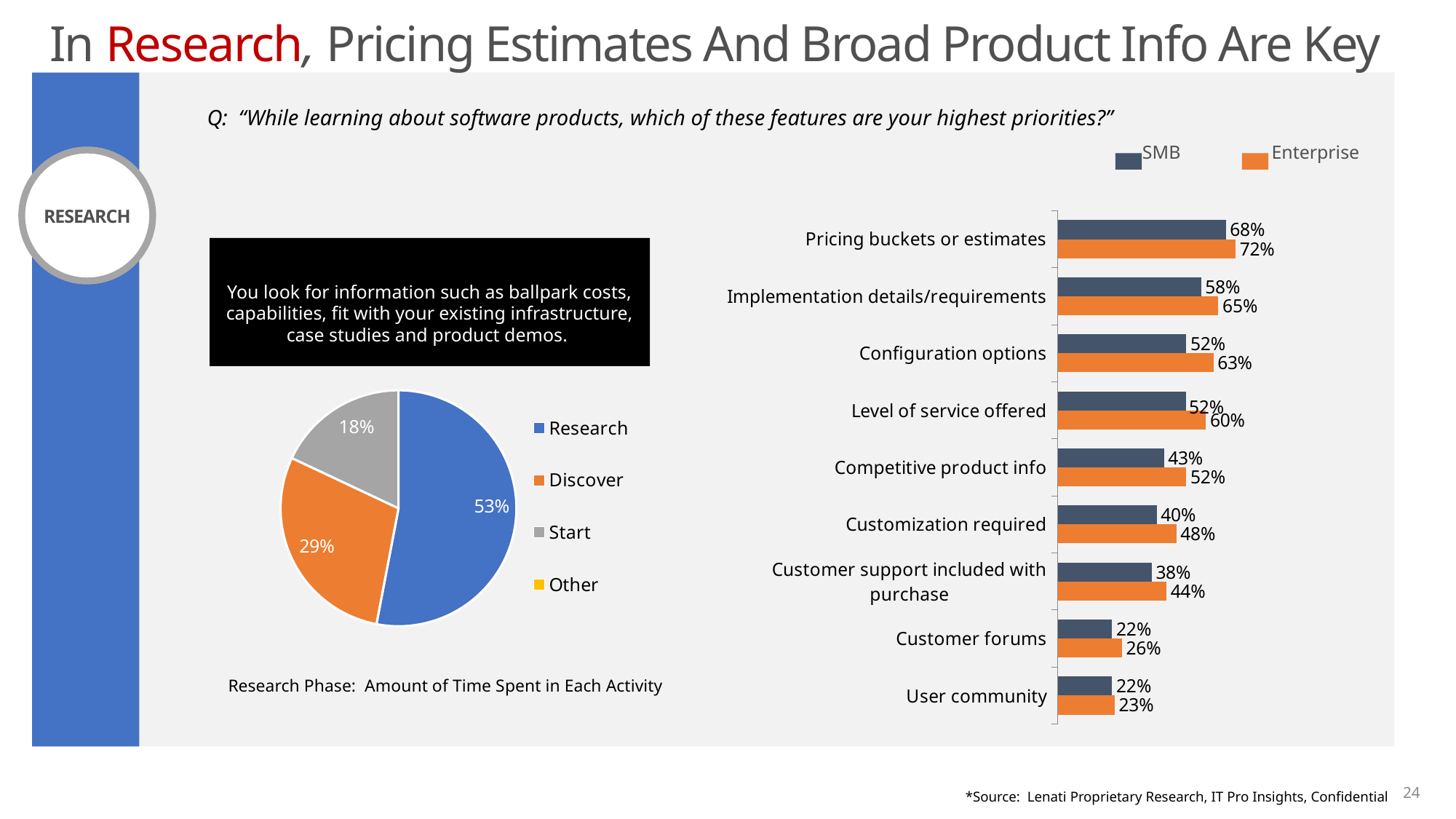
How many categories are shown in the bar chart on the right? 9 What kind of chart is the chart on the right of the slide? Bar chart In the pie chart titled 'Research Phase: Amount of Time Spent in Each Activity', which activity has the smallest labelled slice? Start How many series does the legend of the bar chart on the right list? 2 In the bar chart on the right, what is the SMB value for Customization required? 40% How many entries does the legend of the pie chart list? 4 In the bar chart on the right, which category has the lowest Enterprise value? User community In the bar chart on the right, what is the Enterprise value for Pricing buckets or estimates? 72% In the bar chart on the right, what is the difference between the Enterprise and SMB values for Configuration options? 11% In the bar chart on the right, which category has the highest SMB value? Pricing buckets or estimates In the bar chart on the right, which is larger for Competitive product info: the SMB value or the Enterprise value? Enterprise In the pie chart titled 'Research Phase: Amount of Time Spent in Each Activity', what share does Research have? 53%